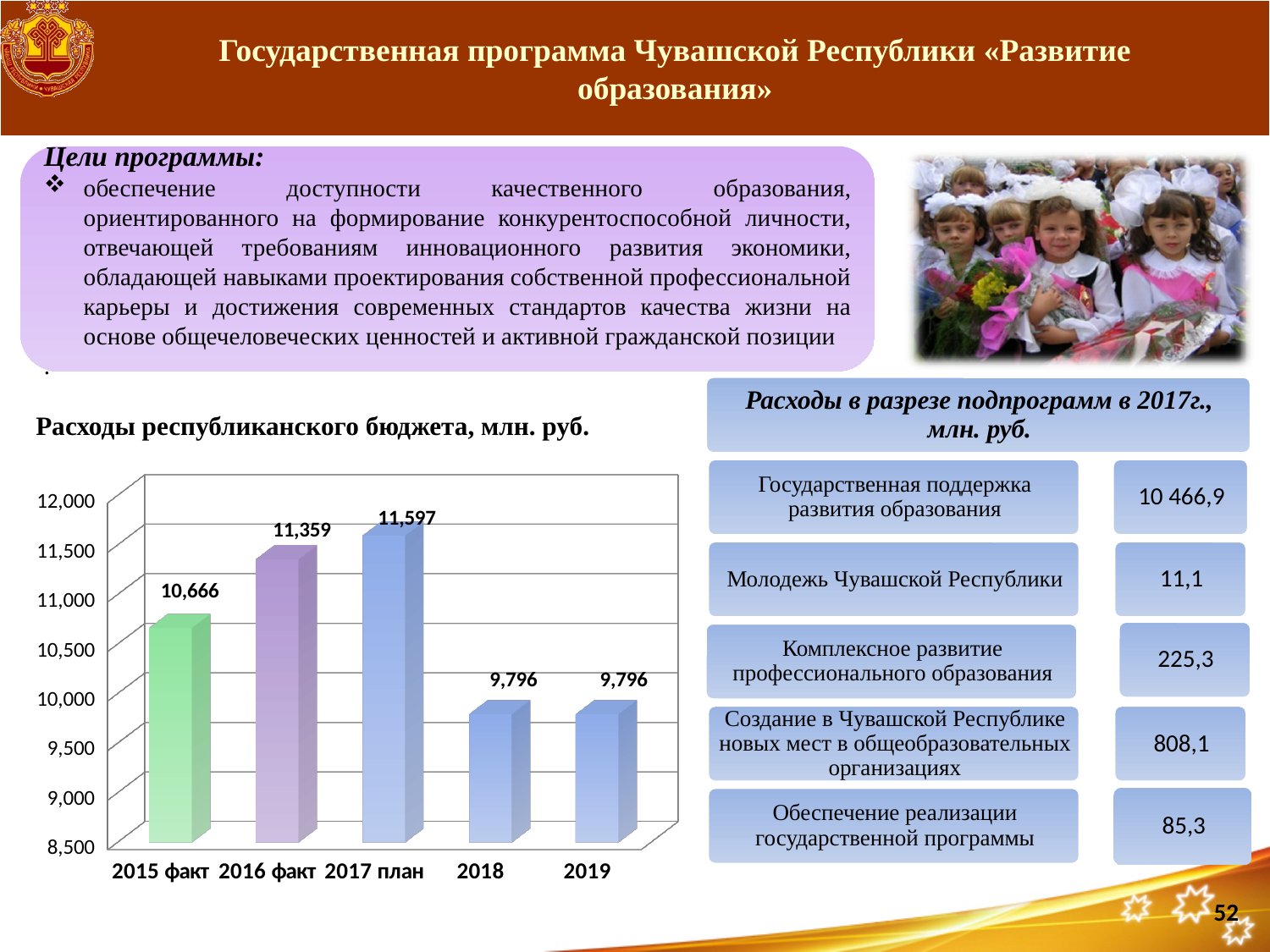
What is the value for 2018 in the chart 'Расходы республиканского бюджета, млн. руб.'? 9,796 Is the value for 2016 факт greater or less than 11,000 in the chart 'Расходы республиканского бюджета, млн. руб.'? greater Which is larger in the chart 'Расходы республиканского бюджета, млн. руб.': the value for 2015 факт or the value for 2018? 2015 факт Which category has the highest value in the chart 'Расходы республиканского бюджета, млн. руб.'? 2017 план In the chart 'Расходы республиканского бюджета, млн. руб.', do the values rise or fall from 2015 факт to 2017 план? rise What is the value for 2015 факт in the chart 'Расходы республиканского бюджета, млн. руб.'? 10,666 What kind of chart is 'Расходы республиканского бюджета, млн. руб.'? bar chart What is the difference between the values for 2016 факт and 2015 факт in the chart 'Расходы республиканского бюджета, млн. руб.'? 693 Is the value for 2019 greater or less than 10,000 in the chart 'Расходы республиканского бюджета, млн. руб.'? less What is the value for 2017 план in the chart 'Расходы республиканского бюджета, млн. руб.'? 11,597 What is the difference between the values for 2017 план and 2016 факт in the chart 'Расходы республиканского бюджета, млн. руб.'? 238 How many categories are shown on the x axis of the chart 'Расходы республиканского бюджета, млн. руб.'? 5